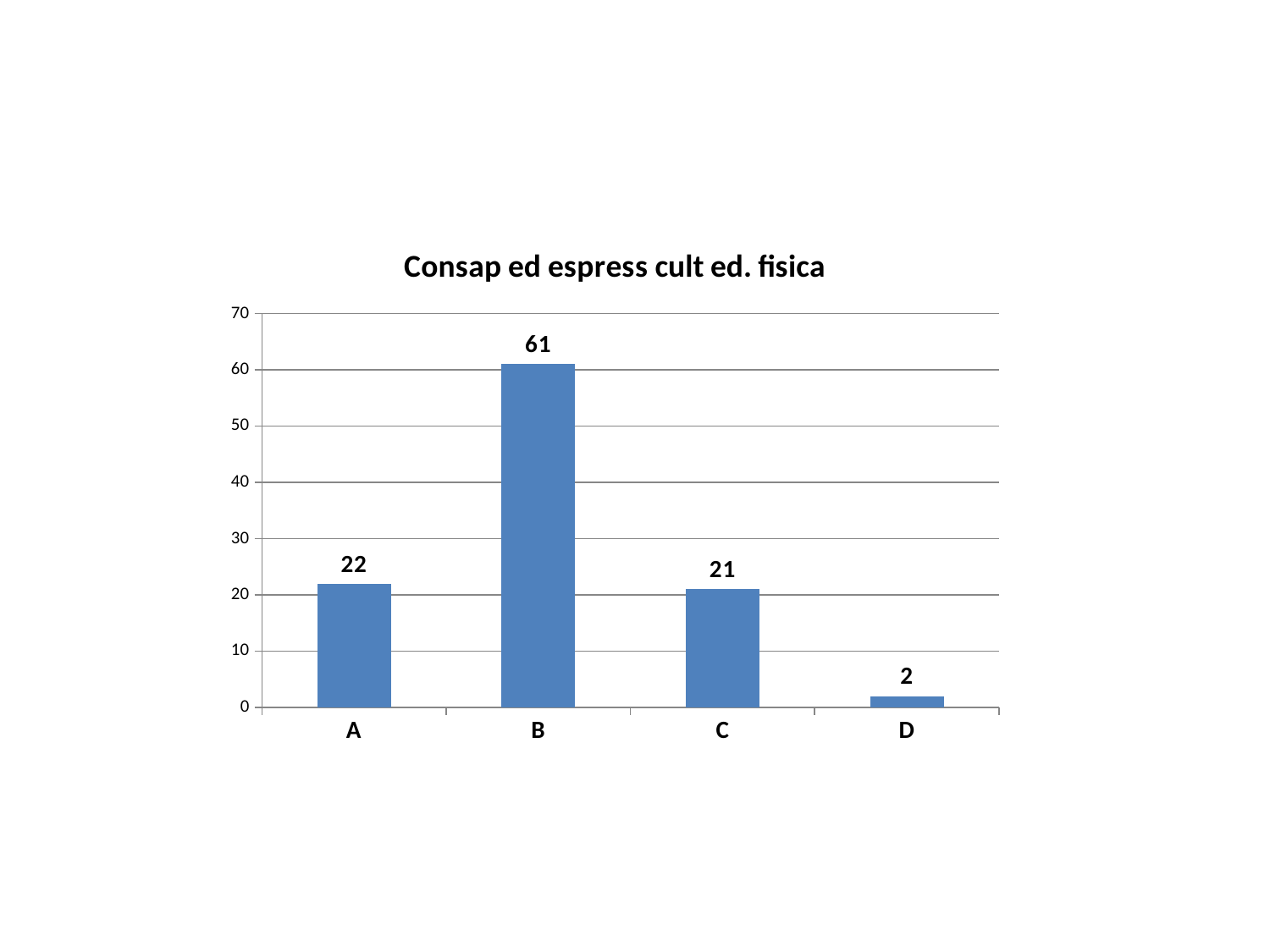
Which category has the highest value? B Which category has the lowest value? D What is the difference between the values for B and A? 39 Is the value for B greater or less than 50? greater What is the difference between the values for C and D? 19 What is the title of the chart? Consap ed espress cult ed. fisica What is the value for category B? 61 Which is larger, the value for B or the value for C? B How many categories are shown on the x axis? 4 What is the value for category A? 22 What kind of chart is shown on the slide? bar chart What is the value for category D? 2